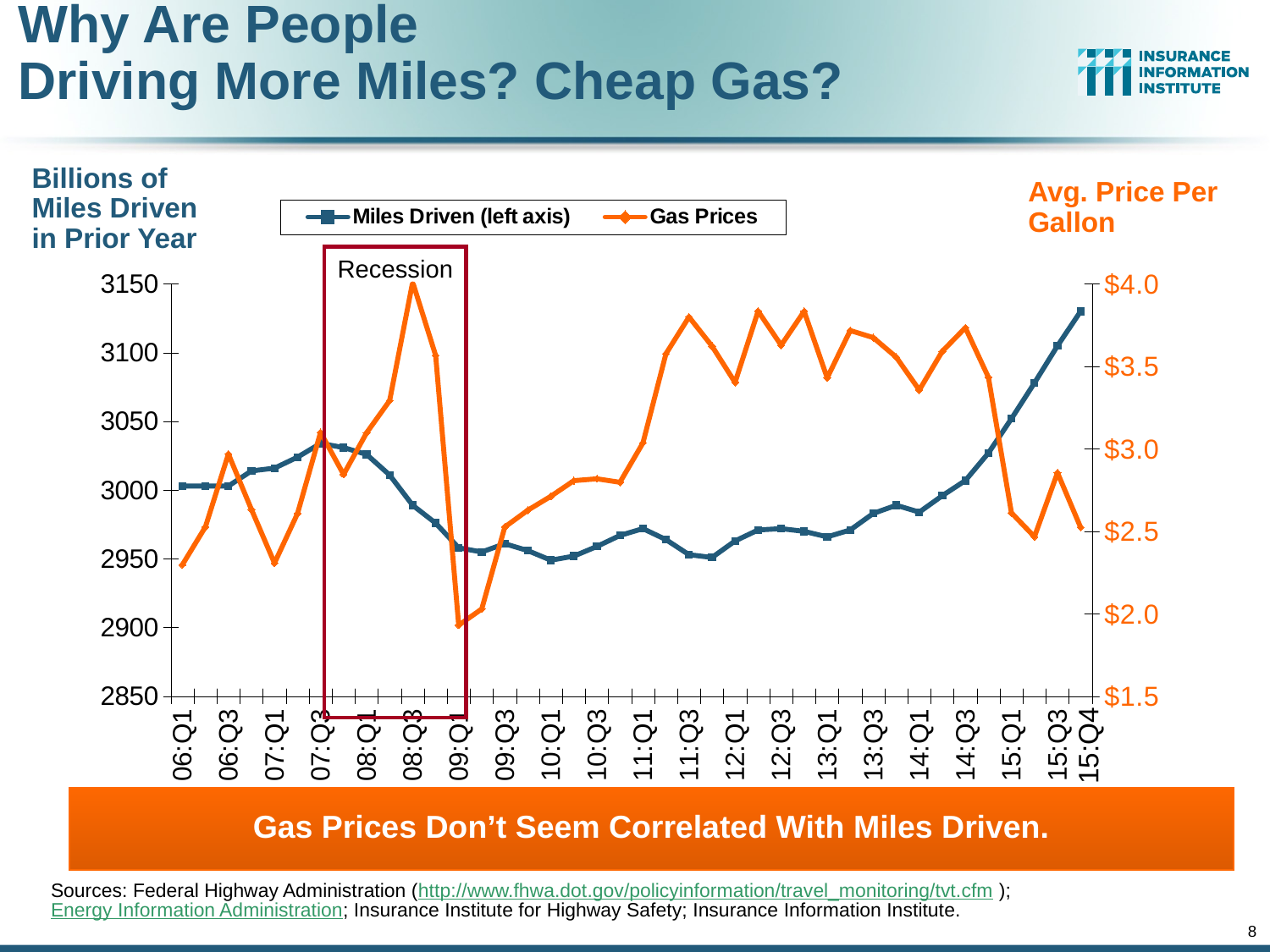
At which quarter does the Gas Prices series reach its highest value? 08:Q3 How many series does the chart's legend list? 2 What kind of chart is shown on the slide? Line chart Is the Gas Prices value for 11:Q3 greater or less than $3.5? greater What label is shown inside the red box on the chart? Recession At which quarter does the Miles Driven series reach its highest value? 15:Q4 Is the Gas Prices value for 06:Q1 greater or less than $2.5? less Is the Miles Driven value for 15:Q4 greater or less than 3100? greater Does the Miles Driven series rise or fall from 14:Q1 to 15:Q4? rise At which quarter does the Gas Prices series reach its lowest value? 09:Q1 What are the two series named in the legend? Miles Driven (left axis) and Gas Prices